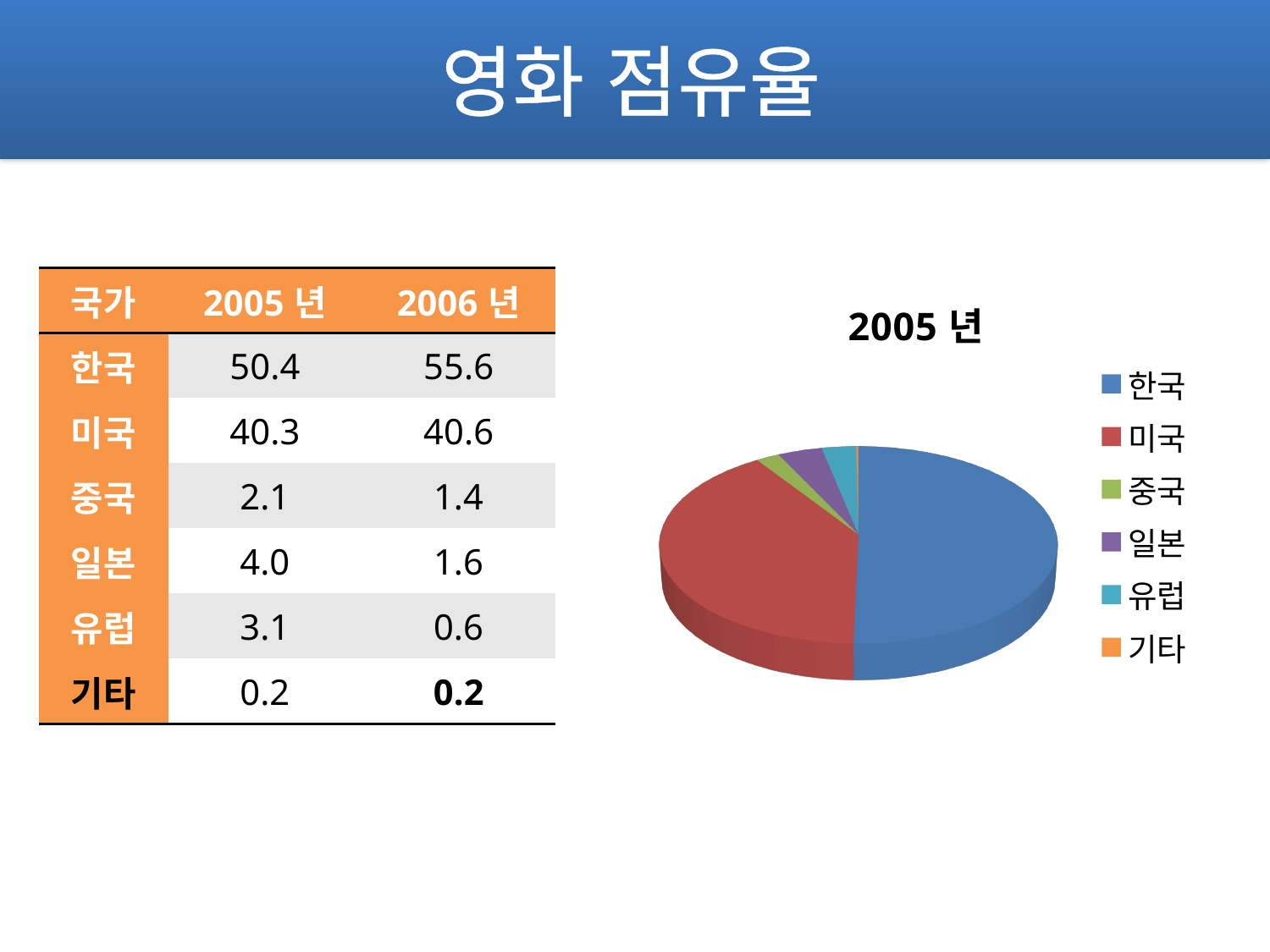
What is the difference between the 2005 년 values for 한국 and 미국? 10.1 How many entries does the pie chart's legend list? 6 What is the 2005 년 value for 한국 shown on the slide? 50.4 In the pie chart, which slice is larger, 한국 or 미국? 한국 Which category has the smallest slice in the pie chart? 기타 Which category has the largest slice in the pie chart? 한국 In the pie chart, which slice is larger, 일본 or 중국? 일본 How many categories does the pie chart show? 6 What is the title of the pie chart? 2005 년 What is the 2005 년 value for 미국 shown on the slide? 40.3 What kind of chart is shown on the slide? pie chart What colour is the 한국 slice in the pie chart? blue